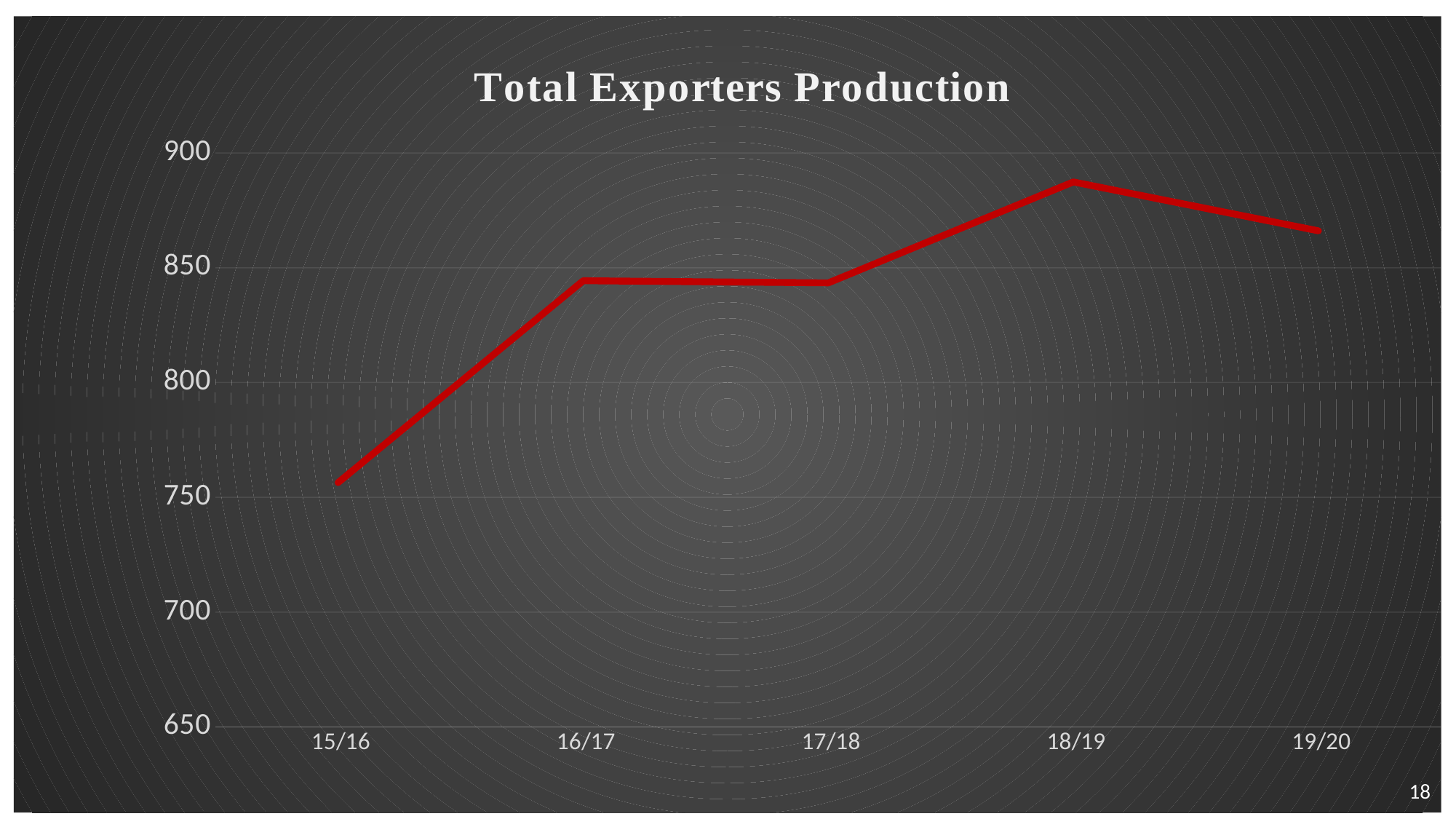
What kind of chart is shown on the slide? line chart Is the value for 16/17 greater or less than 800? greater Which period has the lowest value? 15/16 Is the value for 18/19 greater or less than 850? greater Is the value for 19/20 greater or less than 900? less Which is larger, the value for 18/19 or the value for 19/20? 18/19 How many periods are plotted along the x axis? 5 Which period has the highest value? 18/19 What is the title of the chart? Total Exporters Production Does the value rise or fall from 15/16 to 16/17? rise Does the value rise or fall from 18/19 to 19/20? fall